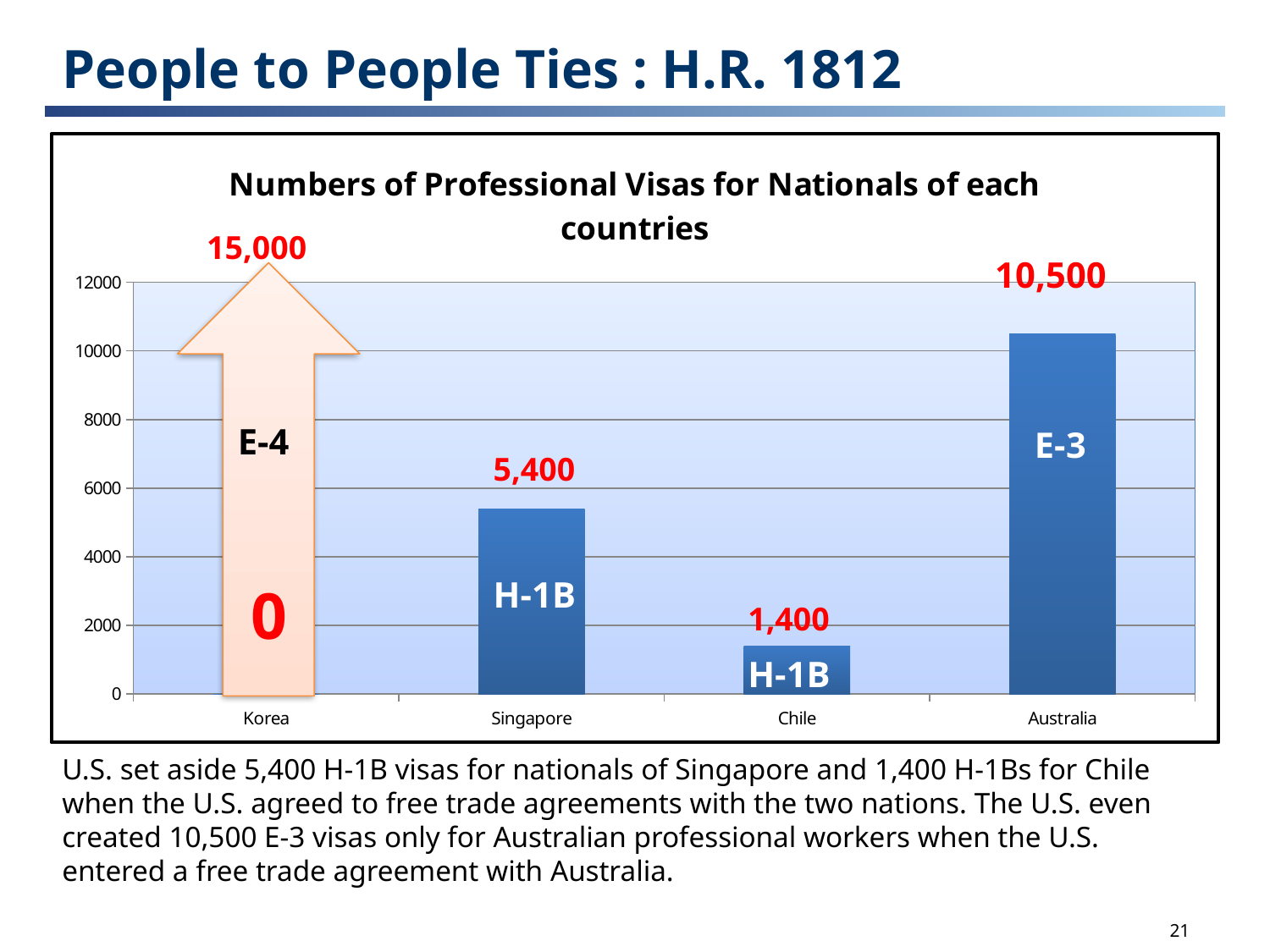
What is the value shown for Chile? 1,400 Which country has the lowest value shown in the chart? Korea Which country has the tallest bar in the chart? Australia What is the value shown for Singapore? 5,400 What is the difference between the values for Singapore and Chile? 4,000 What value is printed for Korea at the base of the arrow? 0 Which is larger, the value for Singapore or the value for Chile? Singapore How many countries are shown on the x axis of the chart? 4 What is the difference between the values for Australia and Singapore? 5,100 What visa type is labelled on the bar for Australia? E-3 What type of chart is shown on the slide? Bar chart What is the value shown for Australia? 10,500